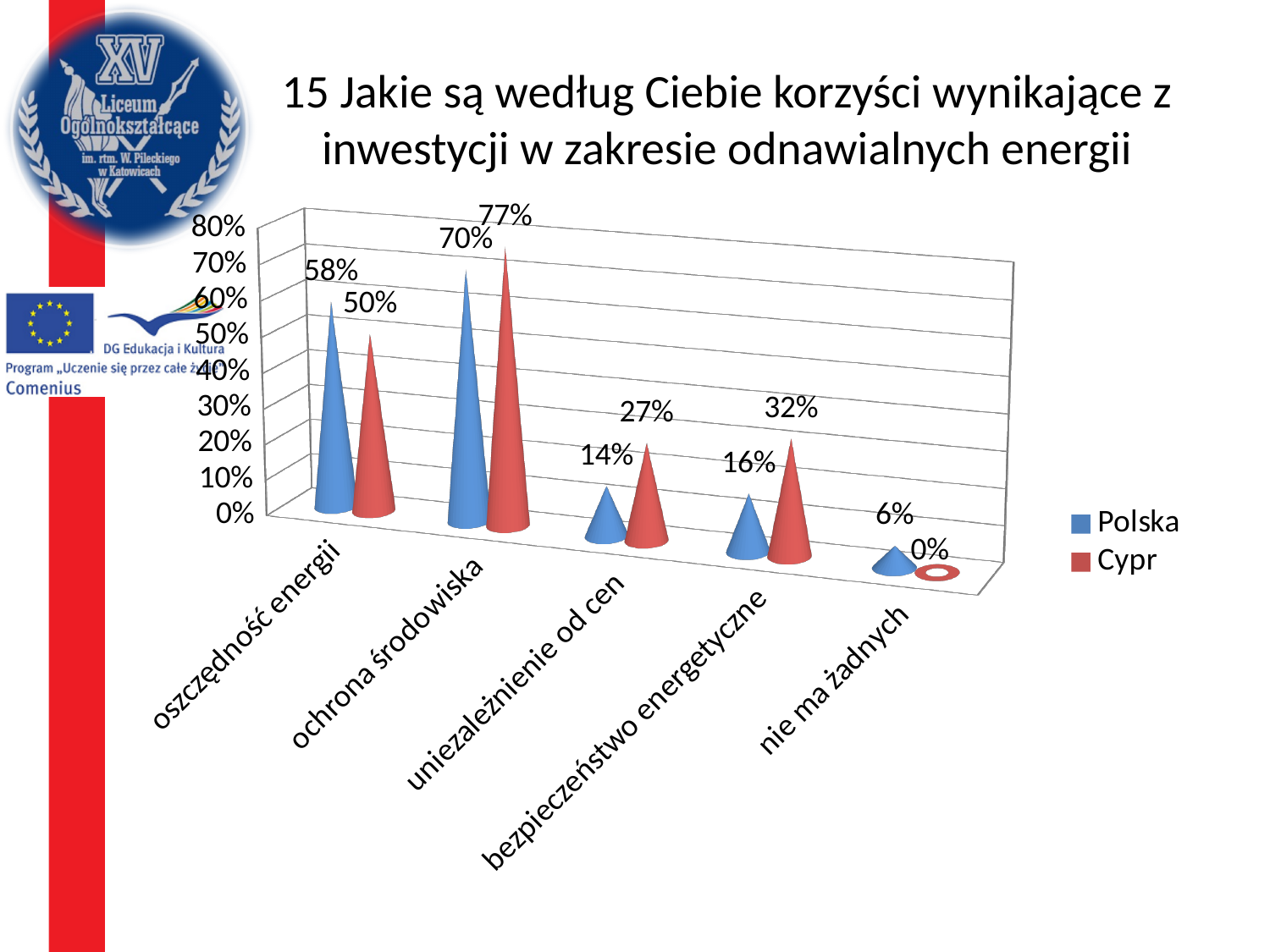
Which category has the lowest value for Polska? nie ma żadnych Which colour represents Cypr in the chart? red What is the value for Polska for "ochrona środowiska"? 70% Is the Polska value for "bezpieczeństwo energetyczne" greater or less than 20%? less For "oszczędność energii", which series has the larger value, Polska or Cypr? Polska What is the value for Cypr for "bezpieczeństwo energetyczne"? 32% How many categories are shown on the x axis? 5 Which category has the highest value for Cypr? ochrona środowiska How many series does the legend list? 2 What kind of chart is shown on the slide? bar chart What is the difference between the Cypr and Polska values for "uniezależnienie od cen"? 13% What is the value for Cypr for "nie ma żadnych"? 0%